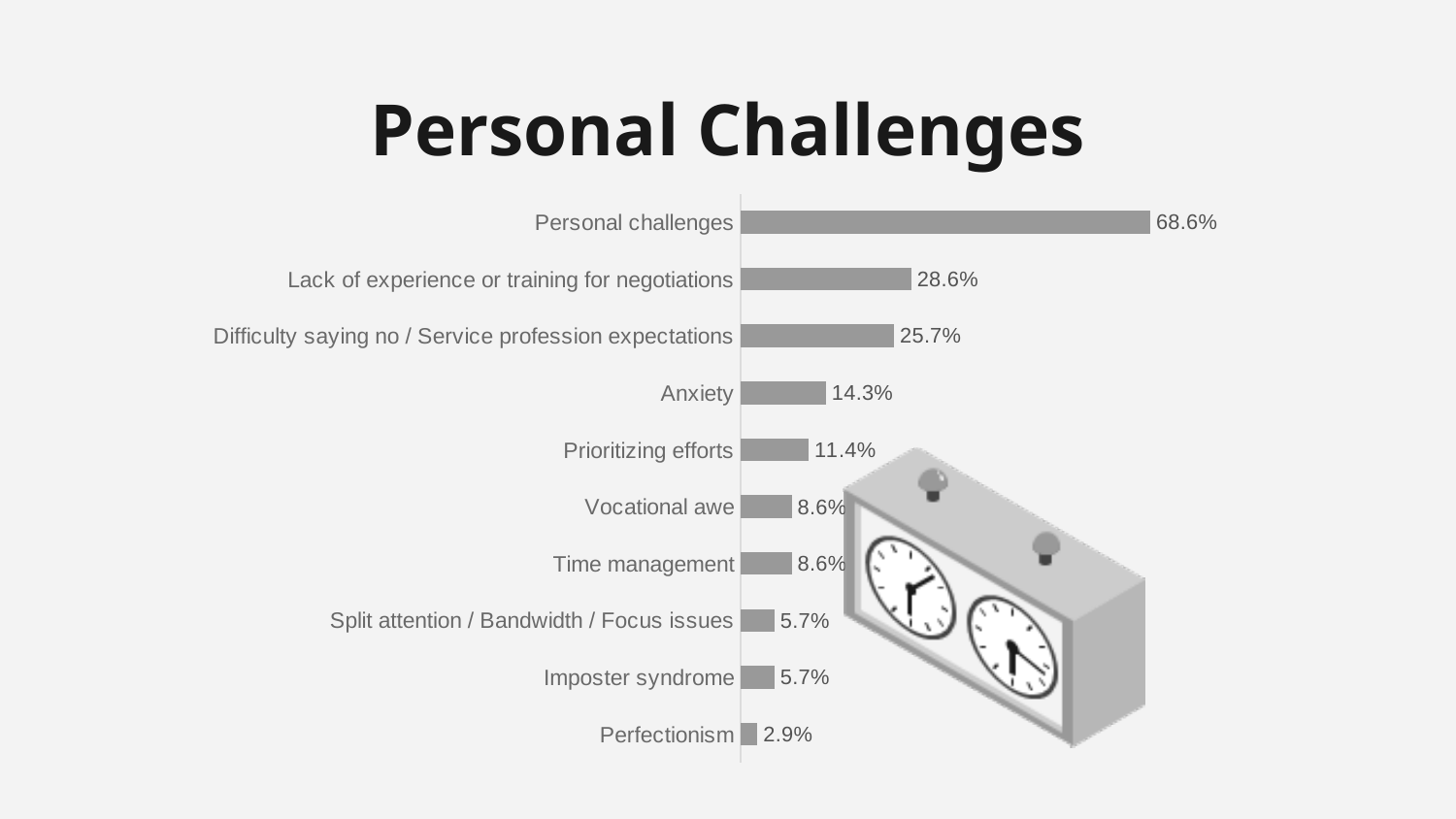
What is the difference between Personal challenges and Lack of experience or training for negotiations? 40.0% Which category has the lowest value? Perfectionism Which is larger, Lack of experience or training for negotiations or Difficulty saying no / Service profession expectations? Lack of experience or training for negotiations What is the value for Prioritizing efforts? 11.4% What is the value for Anxiety? 14.3% What is the title of the slide? Personal Challenges How many categories are shown in the chart? 10 What kind of chart is shown on the slide? Bar chart What is the value for Lack of experience or training for negotiations? 28.6% What is the difference between Difficulty saying no / Service profession expectations and Anxiety? 11.4% Which category has the highest value? Personal challenges What is the value for Imposter syndrome? 5.7%